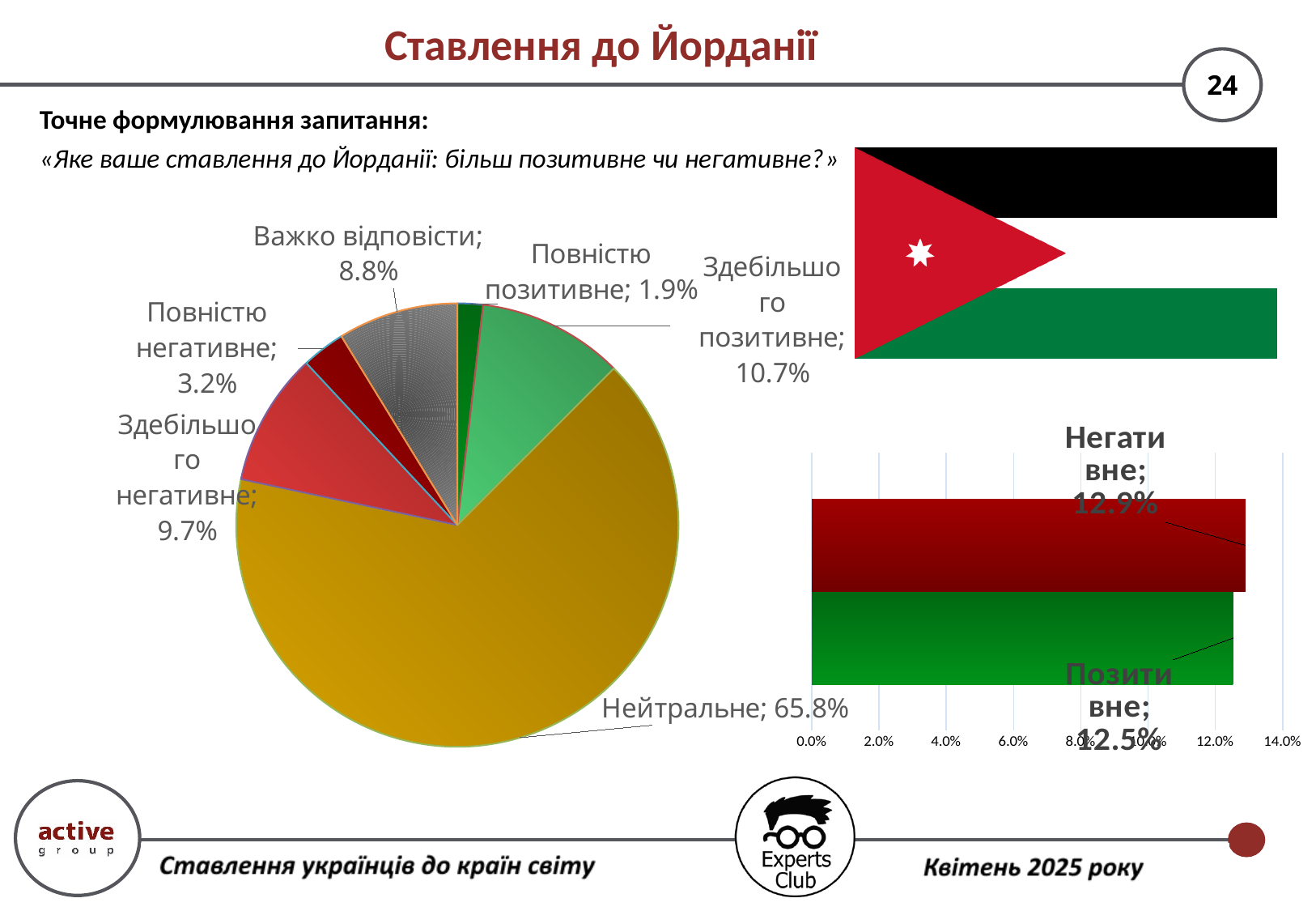
In the pie chart, which category has the largest share? Нейтральне What type of chart is shown on the right side of the slide? Bar chart In the pie chart, what is the value for "Важко відповісти"? 8.8% In the pie chart, what share of respondents answered "Нейтральне"? 65.8% In the bar chart on the right, what is the difference between "Негативне" and "Позитивне"? 0.4% In the pie chart, what is the difference between "Здебільшого негативне" and "Повністю негативне"? 6.5% In the bar chart on the right, what is the value for "Позитивне"? 12.5% In the pie chart, which is larger: "Здебільшого позитивне" or "Здебільшого негативне"? Здебільшого позитивне In the bar chart on the right, what is the value for "Негативне"? 12.9% In the pie chart, which category has the smallest share? Повністю позитивне In the pie chart, how many categories are shown? 6 In the pie chart, what is the value for "Здебільшого позитивне"? 10.7%